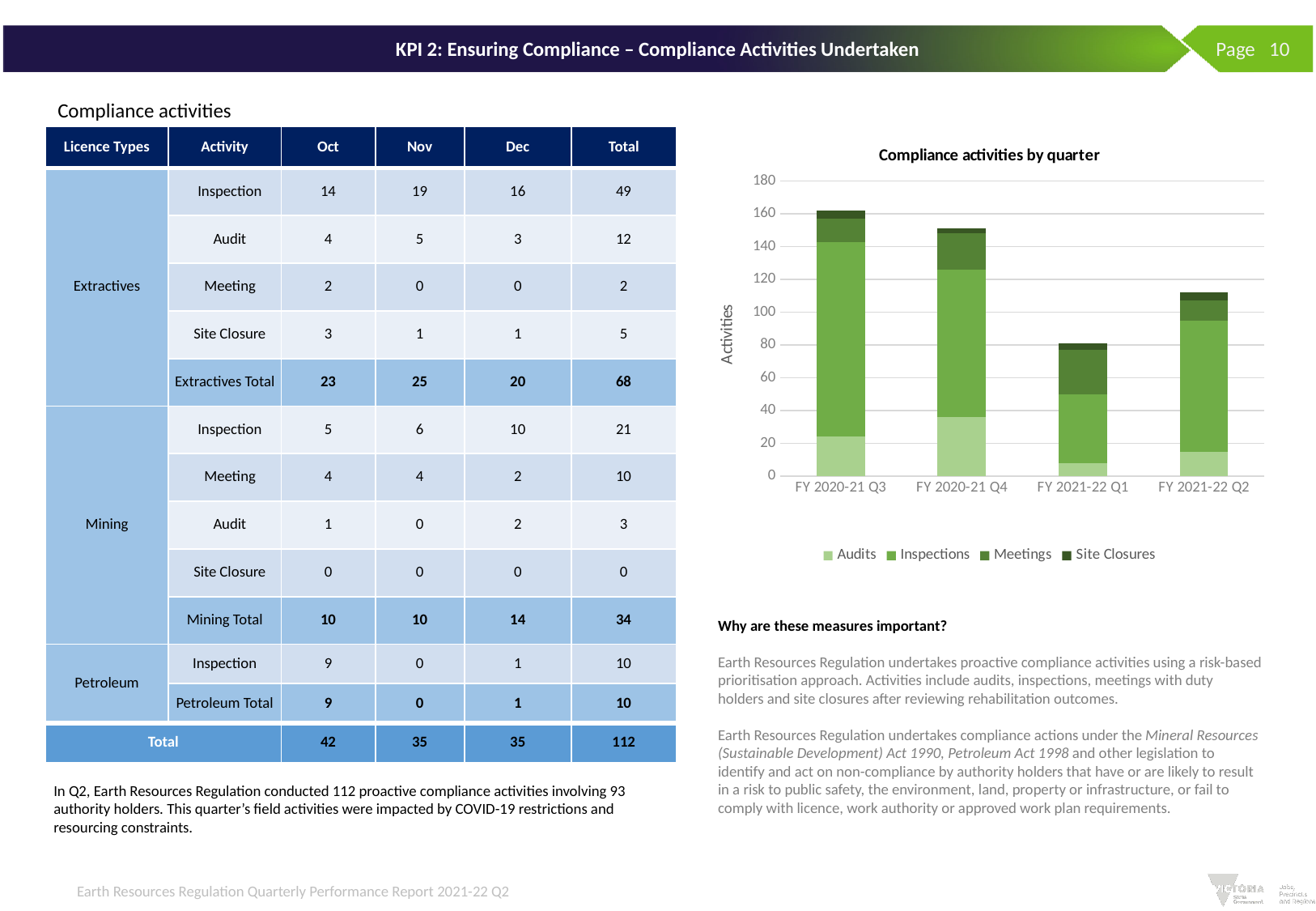
Which quarter has the tallest bar in the 'Compliance activities by quarter' chart? FY 2020-21 Q3 In the 'Compliance activities by quarter' chart, does the total rise or fall from FY 2021-22 Q1 to FY 2021-22 Q2? rise How many quarters are shown on the x axis of the 'Compliance activities by quarter' chart? 4 Which quarter has the shortest bar in the 'Compliance activities by quarter' chart? FY 2021-22 Q1 What are the four legend entries in the 'Compliance activities by quarter' chart? Audits, Inspections, Meetings, Site Closures What is the title of the chart on the slide? Compliance activities by quarter In the 'Compliance activities by quarter' chart, is the total for FY 2021-22 Q2 greater or less than 100? greater How many series does the legend of the 'Compliance activities by quarter' chart list? 4 In the 'Compliance activities by quarter' chart, is the total for FY 2021-22 Q1 greater or less than 100? less In the 'Compliance activities by quarter' chart, which bar is taller: FY 2020-21 Q4 or FY 2021-22 Q2? FY 2020-21 Q4 In the 'Compliance activities by quarter' chart, is the total for FY 2020-21 Q3 greater or less than 140? greater What kind of chart is 'Compliance activities by quarter'? Stacked bar chart